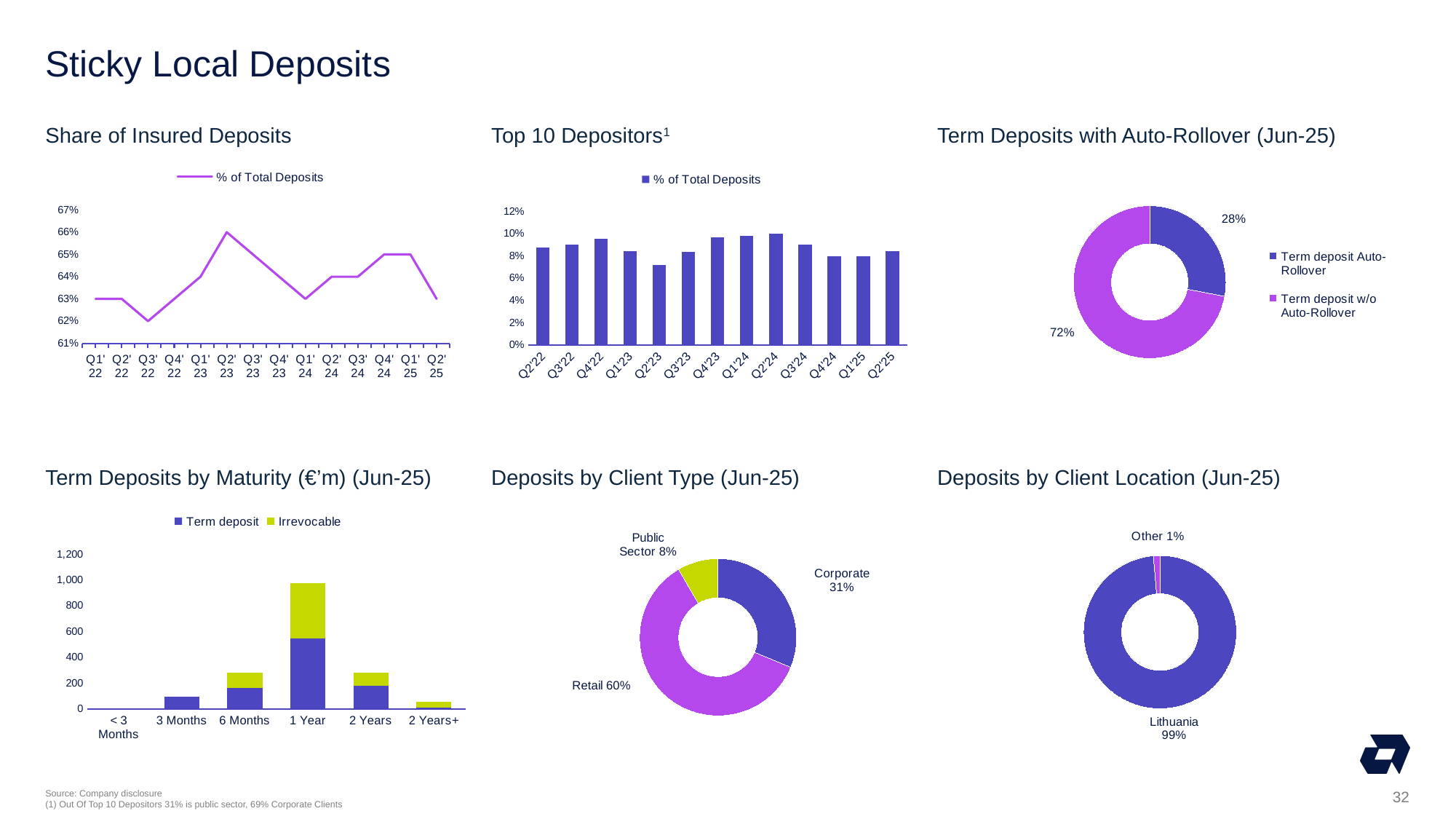
In the 'Share of Insured Deposits' chart, which quarter has the highest share of total deposits? Q2' 23 In the 'Top 10 Depositors' chart, how many quarters are shown on the x axis? 13 In the 'Term Deposits by Maturity (€'m) (Jun-25)' chart, which maturity bucket has the tallest stacked bar? 1 Year In the 'Share of Insured Deposits' chart, which quarter has the lowest share of total deposits? Q3' 22 In the 'Top 10 Depositors' chart, is the value for Q2'23 greater or less than 8%? less In the 'Deposits by Client Location (Jun-25)' chart, what is the share for Lithuania? 99% In the 'Deposits by Client Type (Jun-25)' chart, which client type has the smallest share? Public Sector In the 'Term Deposits by Maturity (€'m) (Jun-25)' chart, how many series does the legend list? 2 In the 'Deposits by Client Type (Jun-25)' chart, what is the difference between the Corporate and Public Sector shares? 23% In the 'Term Deposits with Auto-Rollover (Jun-25)' chart, what share of term deposits is without auto-rollover? 72% In the 'Term Deposits with Auto-Rollover (Jun-25)' chart, what share of term deposits has auto-rollover? 28% In the 'Deposits by Client Type (Jun-25)' chart, what is the share for Retail? 60%